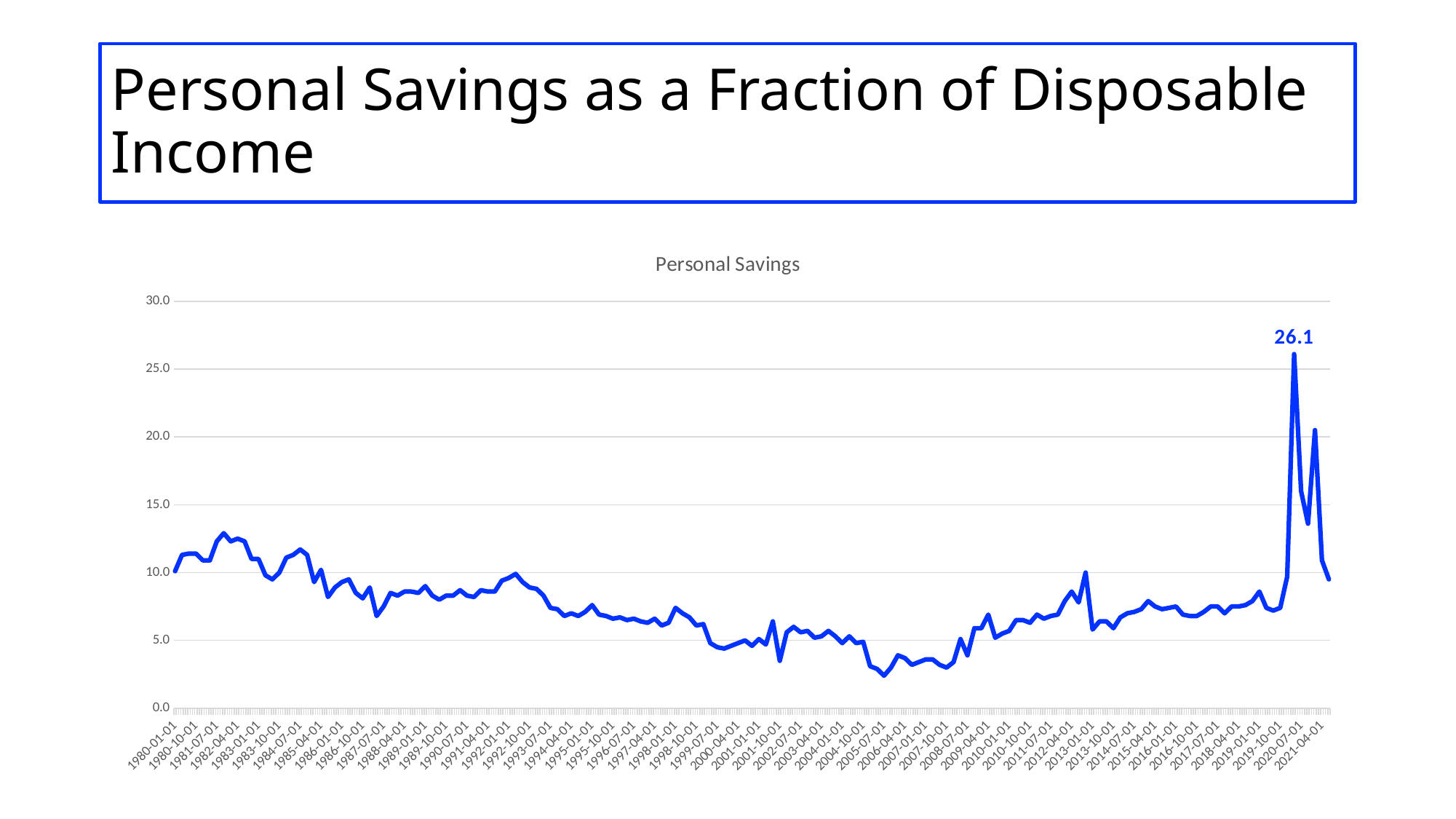
Is the value for 2005-07-01 greater or less than 5.0? less Is the value for 1982-04-01 greater or less than 10.0? greater What is the highest value labeled on the Personal Savings chart? 26.1 What is the highest tick value shown on the vertical axis? 30.0 How many data series are plotted on the Personal Savings chart? 1 What kind of chart is shown on the slide? line chart Is the value for 1980-01-01 greater or less than 5.0? greater From 1980 to 2005, does the Personal Savings line generally rise or fall? fall What is the title of the chart on the slide? Personal Savings From 2005 to 2019, does the Personal Savings line generally rise or fall? rise Which is higher: the value at 1980-01-01 or the value at 2005-07-01? 1980-01-01